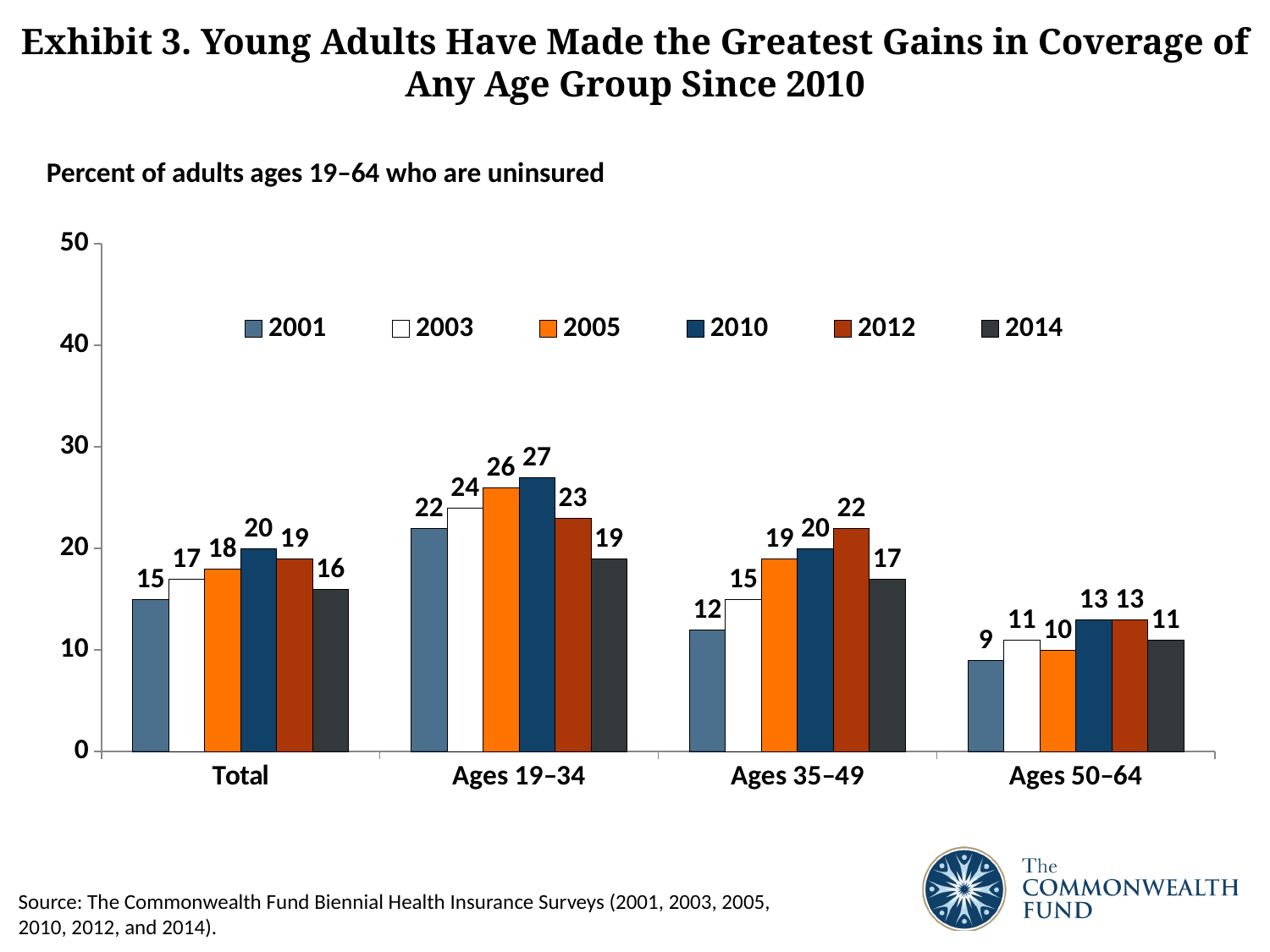
Is the value for Ages 19–34 in 2005 greater or less than 20? greater What kind of chart is shown on the slide? bar chart What is the value for Total in 2014? 16 Which age group has the lowest value in 2003? Ages 50–64 What is the value for Ages 50–64 in 2001? 9 What is the value for Ages 19–34 in 2010? 27 What is the difference between the 2010 and 2014 values for Ages 19–34? 8 What is the subtitle describing what the chart measures? Percent of adults ages 19–64 who are uninsured How many series does the legend list? 6 Which is larger for Ages 35–49: the 2001 value or the 2005 value? 2005 How many age group categories are shown on the x axis? 4 Which age group has the highest value in 2012? Ages 19–34